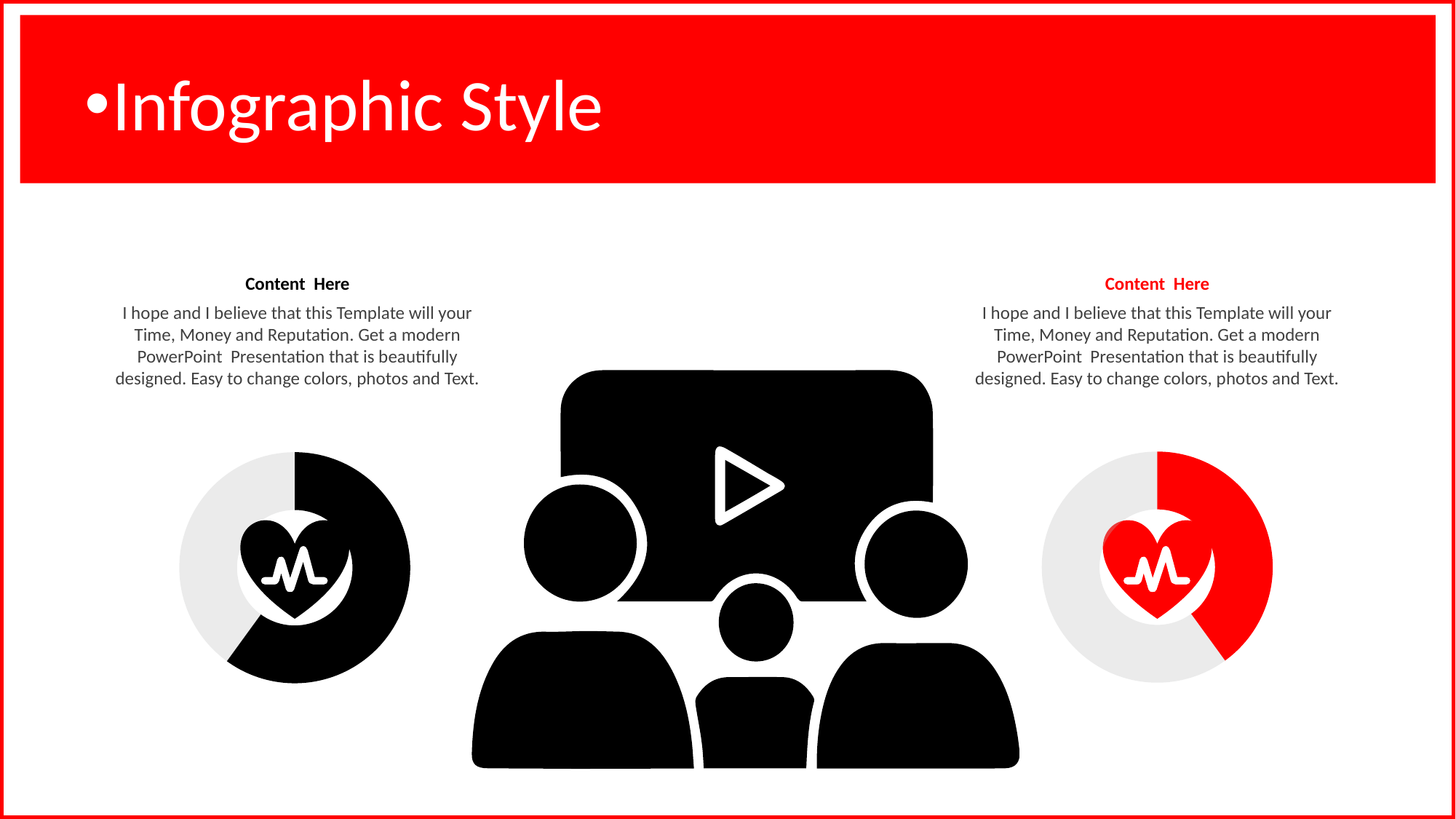
In the right donut chart, how many segments does the ring have? 2 How many donut charts are on the slide? 2 In the left donut chart, how many segments does the ring have? 2 What icon is placed in the centre of each donut chart? A heart with a heartbeat line In the right donut chart, which segment is larger, the red one or the grey one? Grey In the left donut chart, is the black segment more or less than half of the ring? More In the right donut chart, is the grey segment more or less than half of the ring? More What kind of chart is shown on the right side of the slide, below the right 'Content Here' text? Donut chart What kind of chart is shown on the left side of the slide, below the left 'Content Here' text? Donut chart